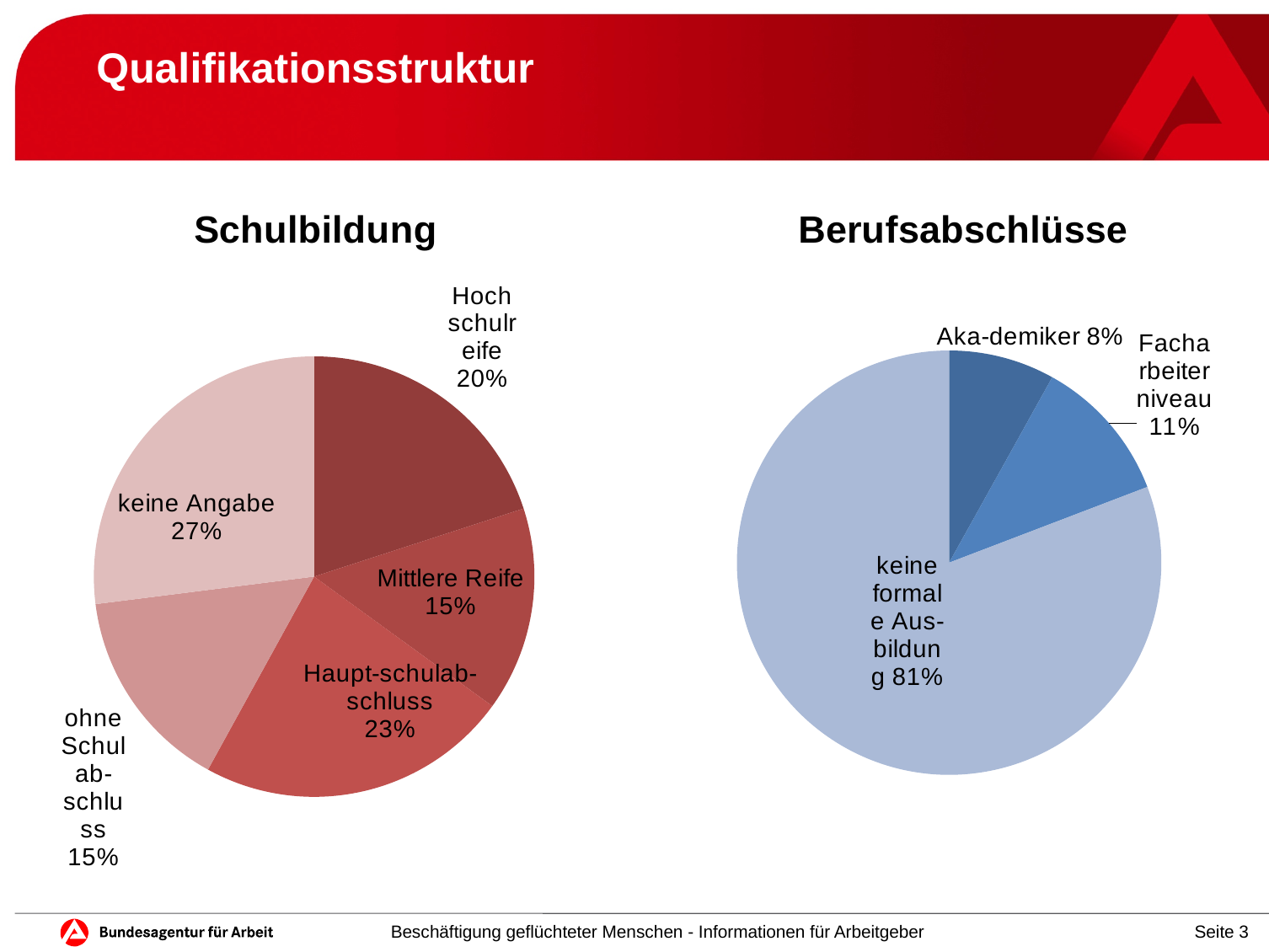
In the Berufsabschlüsse chart, which category has the smallest share? Akademiker In the Schulbildung chart, what is the difference between keine Angabe and Mittlere Reife? 12% In the Schulbildung chart, which category has the largest share? keine Angabe In the Schulbildung chart, what share does keine Angabe have? 27% In the Schulbildung chart, what share does Hochschulreife have? 20% In the Berufsabschlüsse chart, what share does Facharbeiterniveau have? 11% In the Schulbildung chart, which is larger: Hochschulreife or Hauptschulabschluss? Hauptschulabschluss In the Berufsabschlüsse chart, how many categories are shown? 3 In the Schulbildung chart, how many categories are shown? 5 What kind of chart is the Berufsabschlüsse chart? Pie chart In the Berufsabschlüsse chart, what share does keine formale Ausbildung have? 81% In the Schulbildung chart, what share does Hauptschulabschluss have? 23%